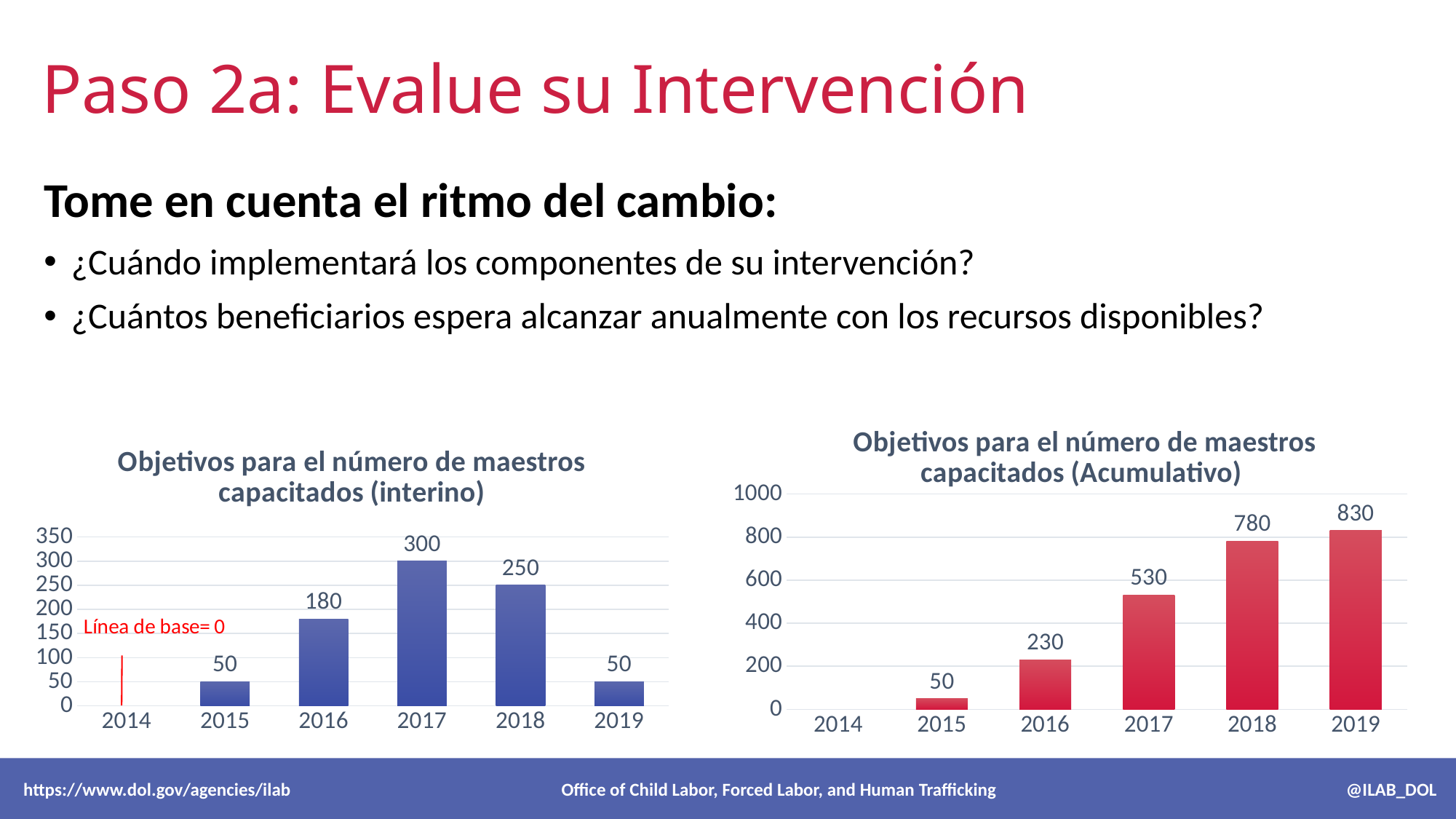
What kind of chart is 'Objetivos para el número de maestros capacitados (interino)'? bar chart In the chart 'Objetivos para el número de maestros capacitados (interino)', what is the value for 2017? 300 In the chart 'Objetivos para el número de maestros capacitados (interino)', what is the difference between the values for 2017 and 2018? 50 In the chart 'Objetivos para el número de maestros capacitados (Acumulativo)', do the values rise or fall from 2015 to 2019? rise In the chart 'Objetivos para el número de maestros capacitados (Acumulativo)', which is larger, the value for 2017 or the value for 2018? 2018 In the chart 'Objetivos para el número de maestros capacitados (Acumulativo)', which year has the highest value? 2019 In the chart 'Objetivos para el número de maestros capacitados (Acumulativo)', what is the value for 2017? 530 In the chart 'Objetivos para el número de maestros capacitados (interino)', what is the value for 2016? 180 In the chart 'Objetivos para el número de maestros capacitados (Acumulativo)', what is the difference between the values for 2018 and 2016? 550 In the chart 'Objetivos para el número de maestros capacitados (interino)', what baseline value is annotated for 2014? Línea de base= 0 In the chart 'Objetivos para el número de maestros capacitados (interino)', which year has the highest value? 2017 In the chart 'Objetivos para el número de maestros capacitados (Acumulativo)', what is the value for 2019? 830